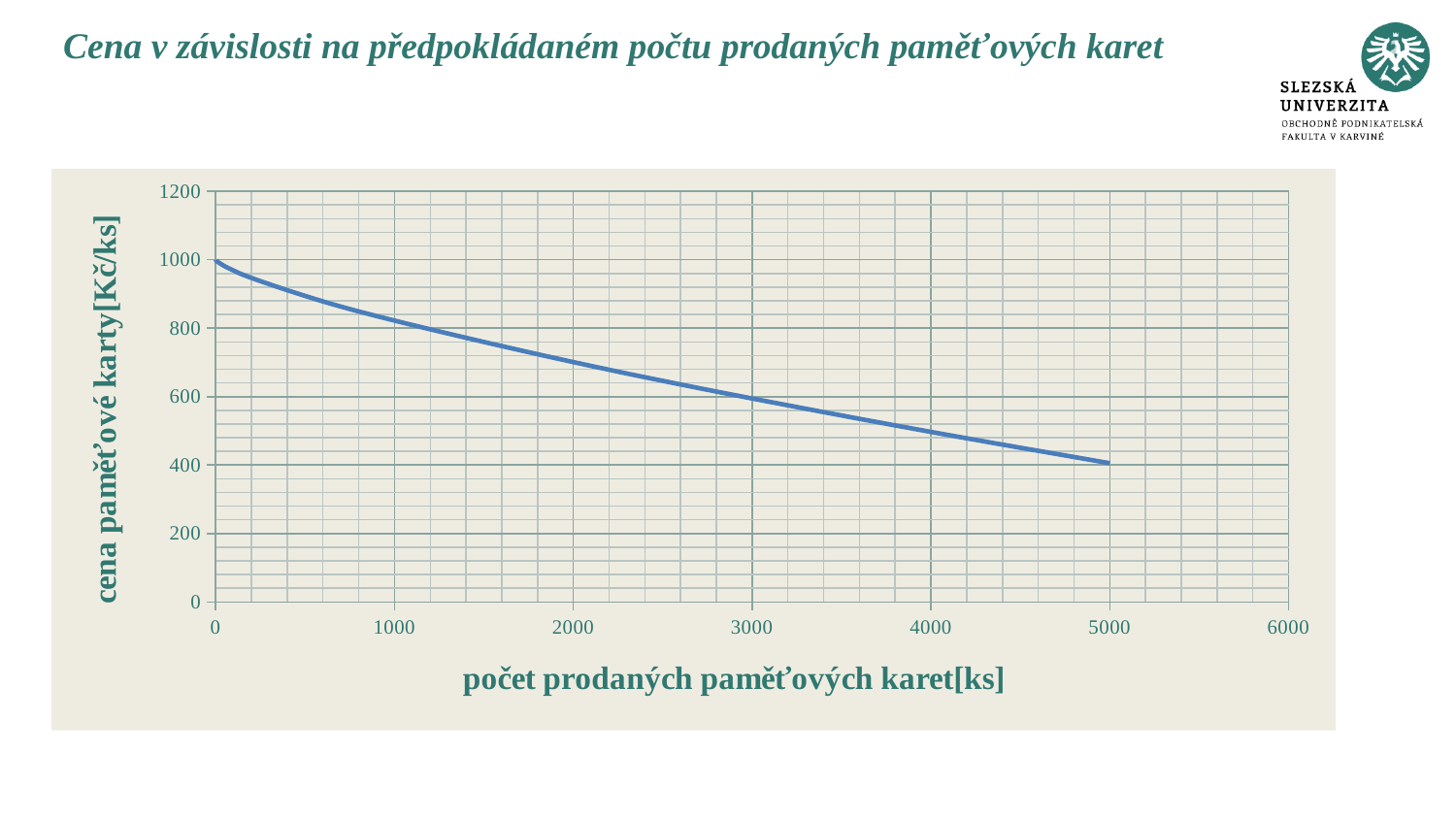
Is the price at 2000 sold memory cards greater or less than 600 Kč/ks? greater Is the price at 0 sold memory cards greater or less than 800 Kč/ks? greater What is the label of the x axis? počet prodaných paměťových karet[ks] What is the label of the y axis? cena paměťové karty[Kč/ks] Is the price at 5000 sold memory cards greater or less than 600 Kč/ks? less Does the price of a memory card rise or fall as the number of sold cards increases along the x axis? fall Is the price at 1000 sold memory cards larger or smaller than the price at 3000 sold memory cards? larger What kind of chart is shown on the slide? line chart